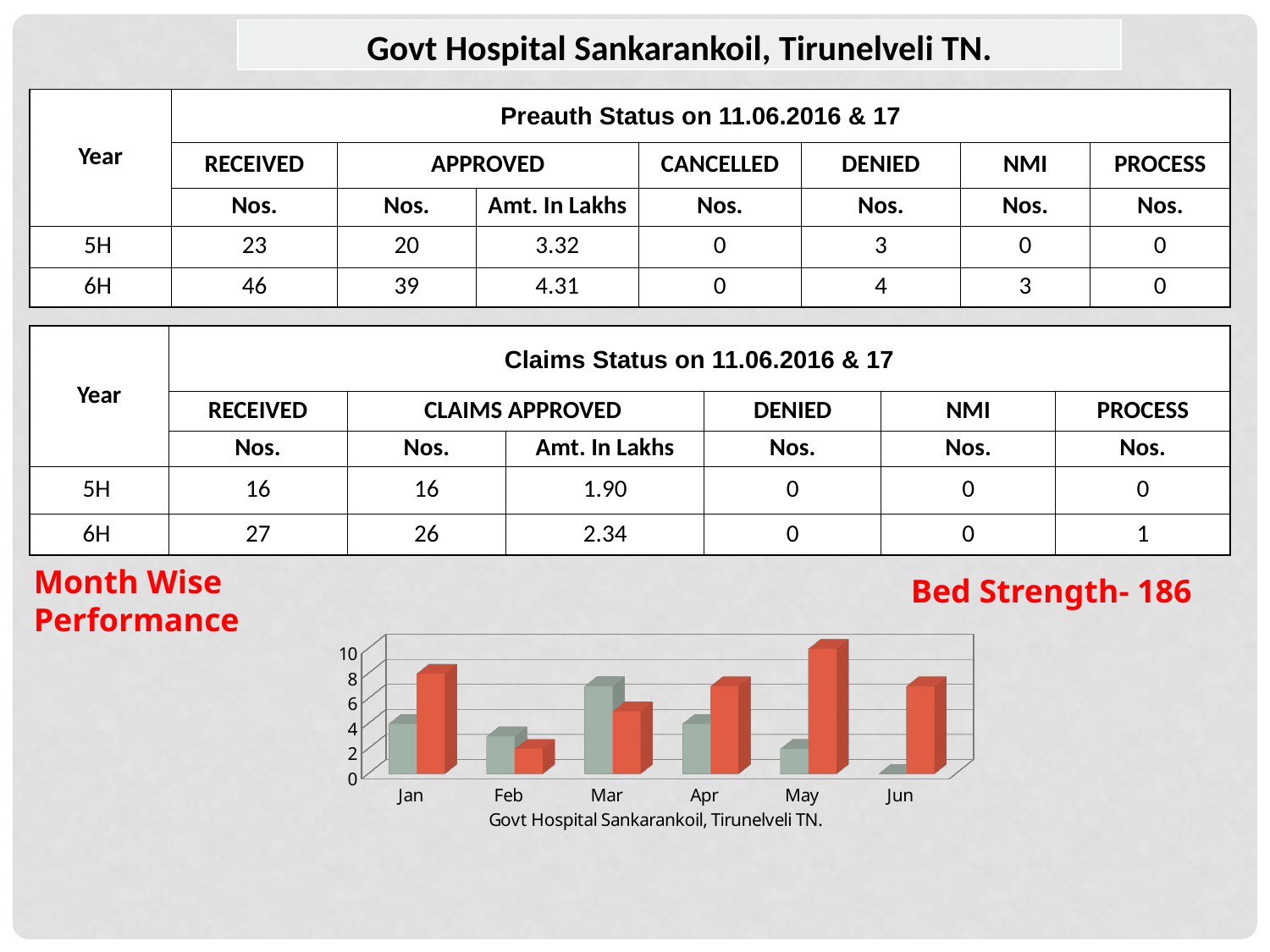
In the bar chart, which month has the tallest grey bar? Mar What title is printed below the bar chart? Govt Hospital Sankarankoil, Tirunelveli TN. Is the grey bar for Feb greater or less than 4? less Is the red bar for May greater or less than 8? greater In Jan, which bar is taller, the grey bar or the red bar? the red bar In the bar chart, which month has the shortest red bar? Feb How many months are shown on the x axis of the bar chart? 6 In Mar, which bar is taller, the grey bar or the red bar? the grey bar In the bar chart, which month has the shortest grey bar? Jun In the bar chart, which month has the tallest red bar? May What kind of chart is shown at the bottom of the slide? bar chart Is the red bar for Jan greater or less than 6? greater